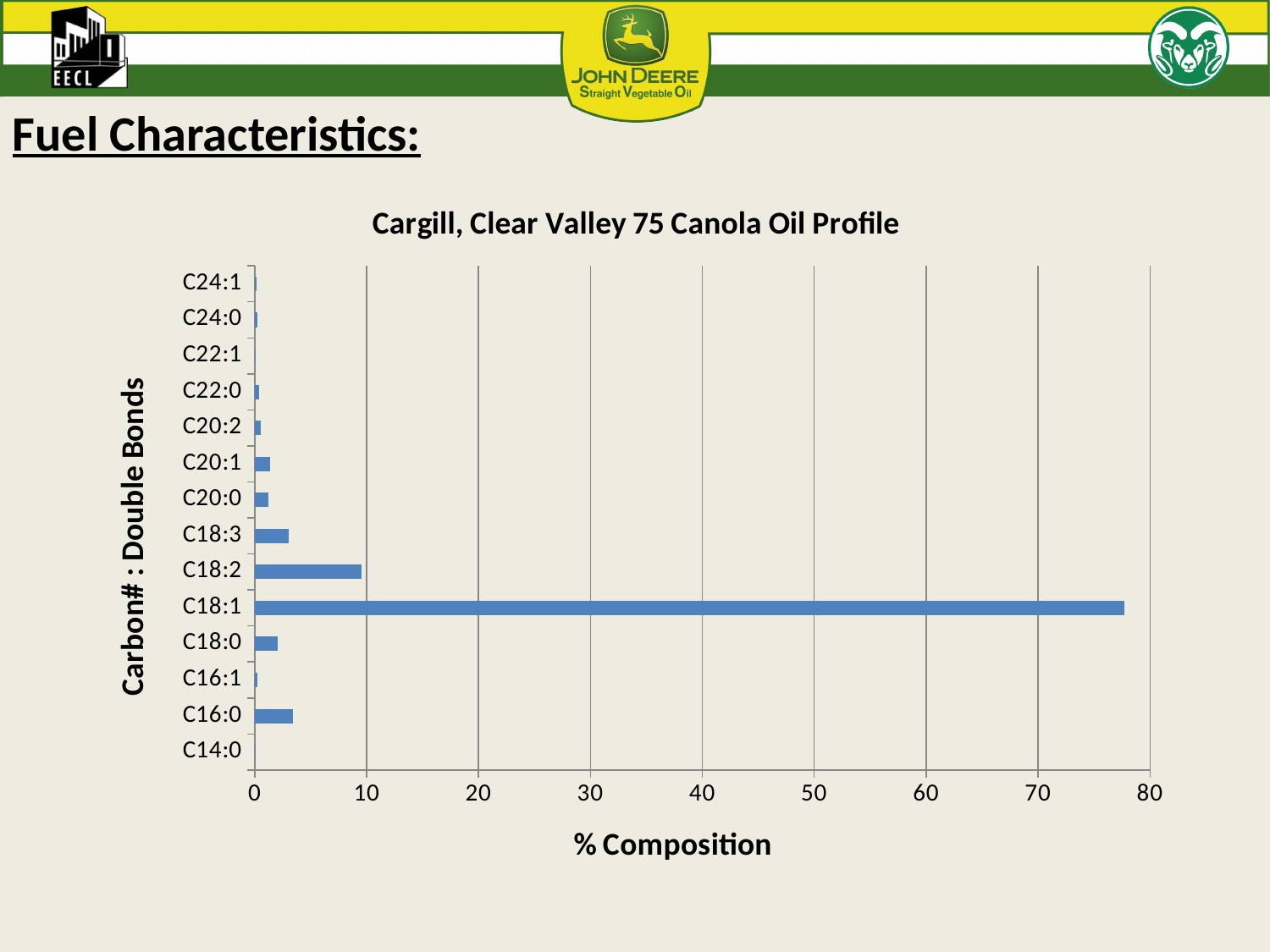
Is the value for C16:0 greater or less than 10? less Is the value for C18:1 greater or less than 80? less What type of chart is shown on the slide? bar chart Which has a larger % Composition, C18:1 or C18:2? C18:1 Which category has the highest % Composition? C18:1 What is the title of the chart? Cargill, Clear Valley 75 Canola Oil Profile Which has a larger % Composition, C18:2 or C18:3? C18:2 How many categories are listed on the vertical axis of the chart? 14 Is the value for C18:1 greater or less than 70? greater What is the label of the horizontal axis of the chart? % Composition Which has a larger % Composition, C16:0 or C18:0? C16:0